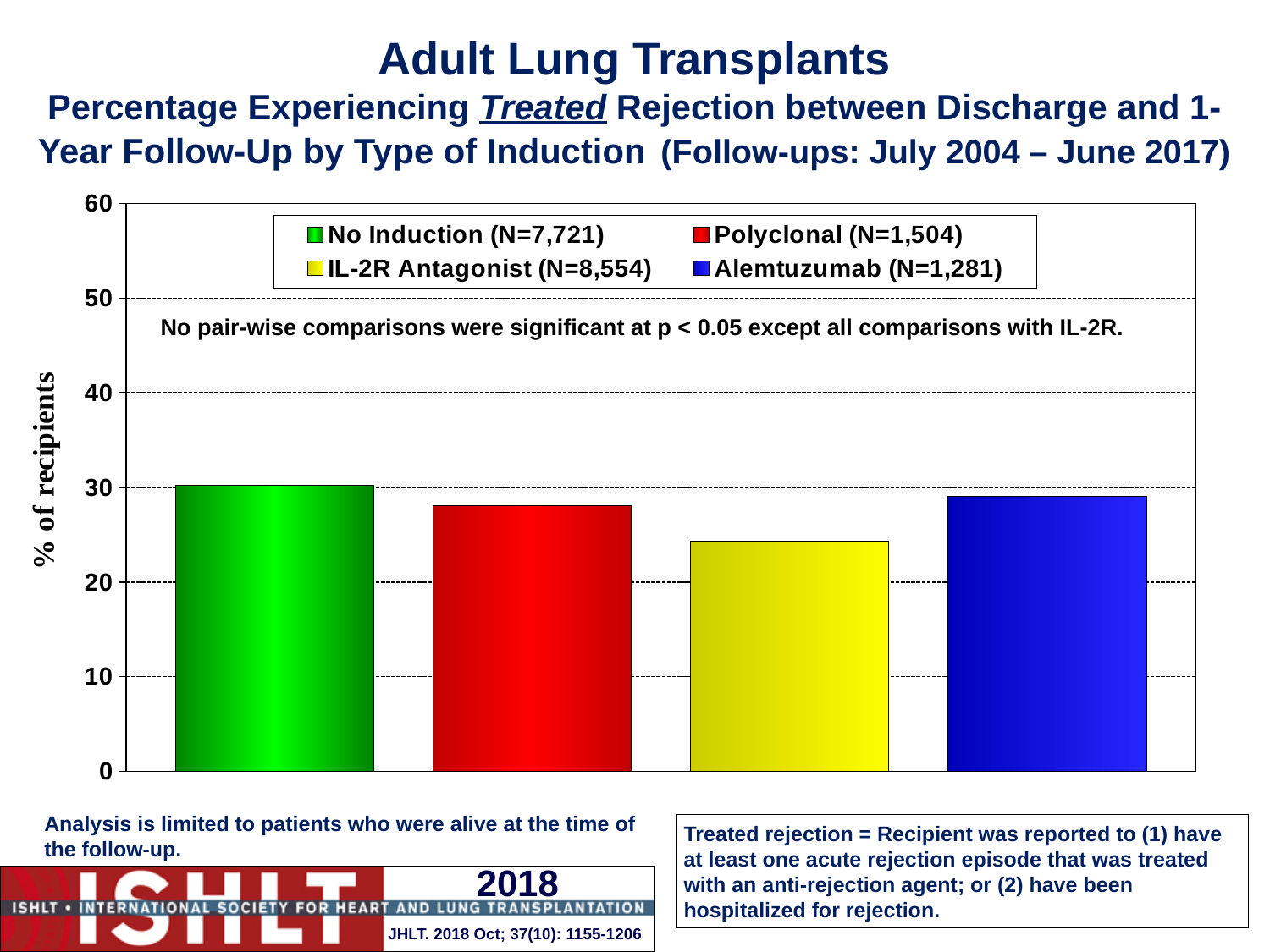
According to the legend, what is the N for the No Induction group? 7,721 How many series does the legend list? 4 What kind of chart is shown on the slide? bar chart Is the value for Polyclonal greater or less than 30? less Which is larger, the value for Polyclonal or the value for IL-2R Antagonist? Polyclonal Is the value for IL-2R Antagonist greater or less than 30? less Which induction type has the lowest percentage of recipients experiencing treated rejection? IL-2R Antagonist What colour is the bar for Alemtuzumab? blue How many induction types (bars) are plotted in the chart? 4 Is the value for Alemtuzumab greater or less than 20? greater Which is larger, the value for No Induction or the value for IL-2R Antagonist? No Induction